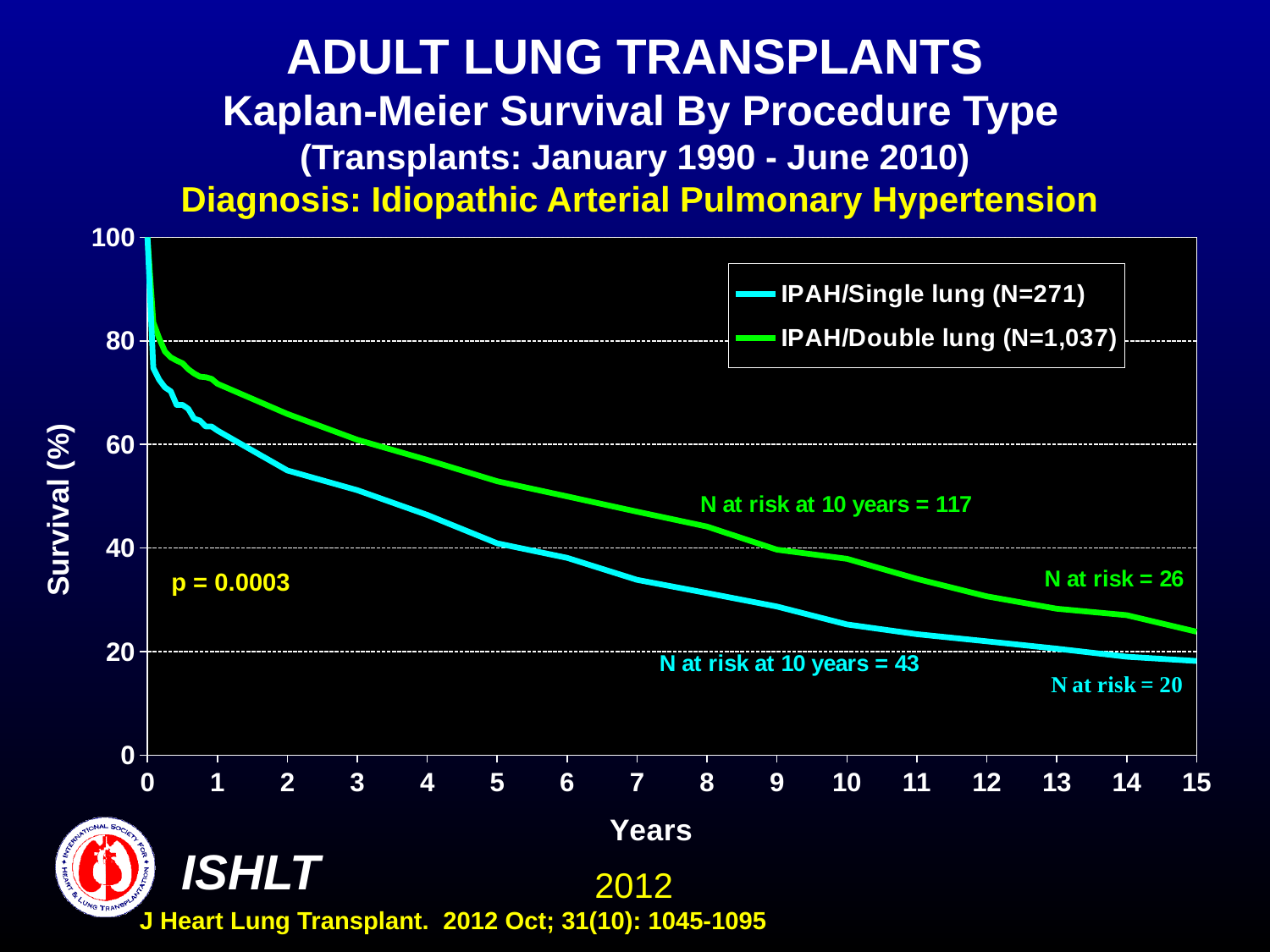
What is the N at risk at 10 years for the IPAH/Double lung group? 117 What is the N at risk at 10 years for the IPAH/Single lung group? 43 Is the survival for IPAH/Single lung at 10 years greater or less than 40%? less Do the survival curves rise or fall as years increase? fall What is the N at risk at 15 years for the IPAH/Double lung group? 26 Is the survival for IPAH/Double lung at 5 years greater or less than 40%? greater Which group has higher survival at 5 years, IPAH/Single lung or IPAH/Double lung? IPAH/Double lung What kind of chart is shown on the slide? line chart What is the p-value shown on the chart? p = 0.0003 What is the N at risk at 15 years for the IPAH/Single lung group? 20 What is the sample size (N) for the IPAH/Double lung group in the legend? 1,037 How many series does the legend list? 2